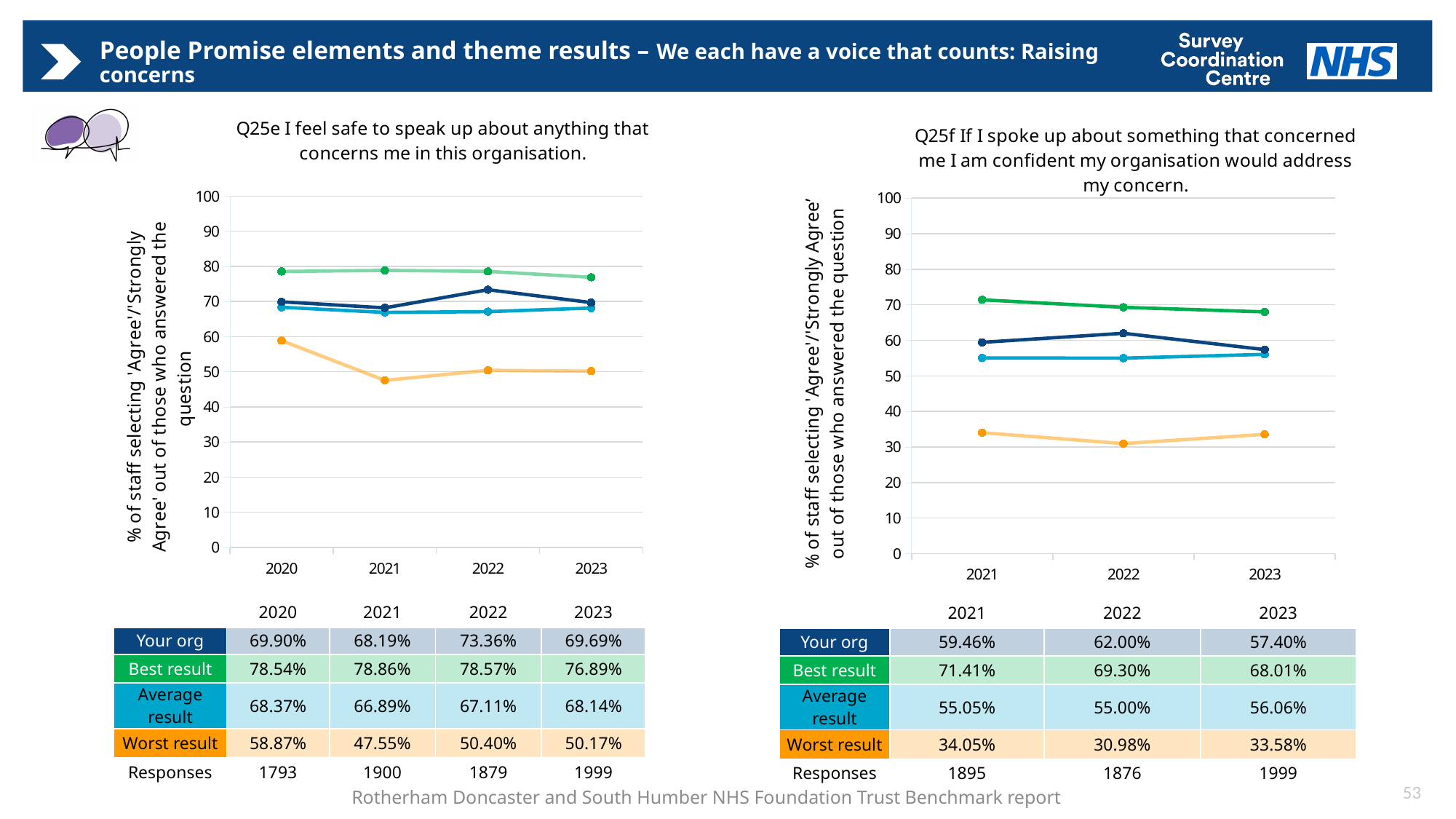
In the Q25e chart, what was the 'Worst result' value in 2021? 47.55% In the Q25f chart, which is larger in 2022: 'Your org' or 'Average result'? Your org In the Q25f chart, what was the 'Best result' value in 2021? 71.41% In the Q25f chart, is the 'Worst result' value for 2021 greater or less than 40? less In the Q25f chart, in which year was the 'Worst result' value lowest? 2022 What kind of chart is used for Q25f? Line chart In the Q25f chart, what was the 'Average result' value in 2023? 56.06% In the Q25e chart, what was the 'Your org' value in 2022? 73.36% In the Q25e chart, what is the difference between the 'Best result' and 'Your org' values in 2023? 7.20% In the Q25f chart, does the 'Best result' line rise or fall from 2021 to 2023? Fall In the Q25e chart, in which year was the 'Your org' value highest? 2022 How many years are plotted on the x axis of the Q25e chart? 4